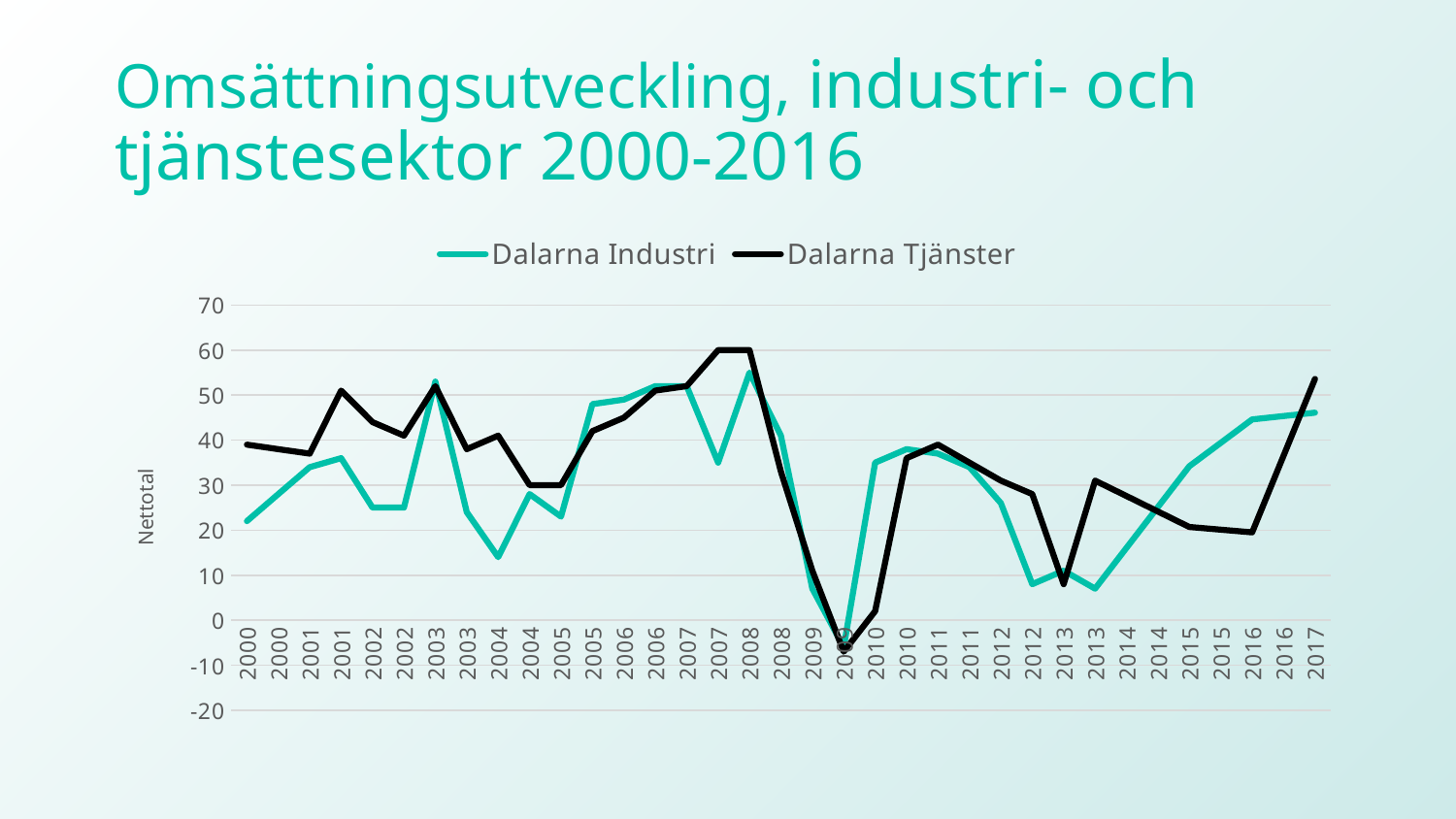
Is the value for Dalarna Tjänster at the second 2016 point greater or less than 30? greater What kind of chart is shown on the slide? Line chart What is the label on the vertical axis of the chart? Nettotal At the 2017 point, which series has the higher value, Dalarna Industri or Dalarna Tjänster? Dalarna Tjänster Is the value for Dalarna Industri at the first 2004 point greater or less than 20? less Is the value for Dalarna Industri at the first 2016 point greater or less than 40? greater Does the Dalarna Industri line rise or fall between the 2014 points and the 2016 points? Rise At the first 2016 point, which series has the higher value, Dalarna Industri or Dalarna Tjänster? Dalarna Industri Which series is drawn in black? Dalarna Tjänster Which series reaches the highest value anywhere on the chart? Dalarna Tjänster How many series does the legend list? 2